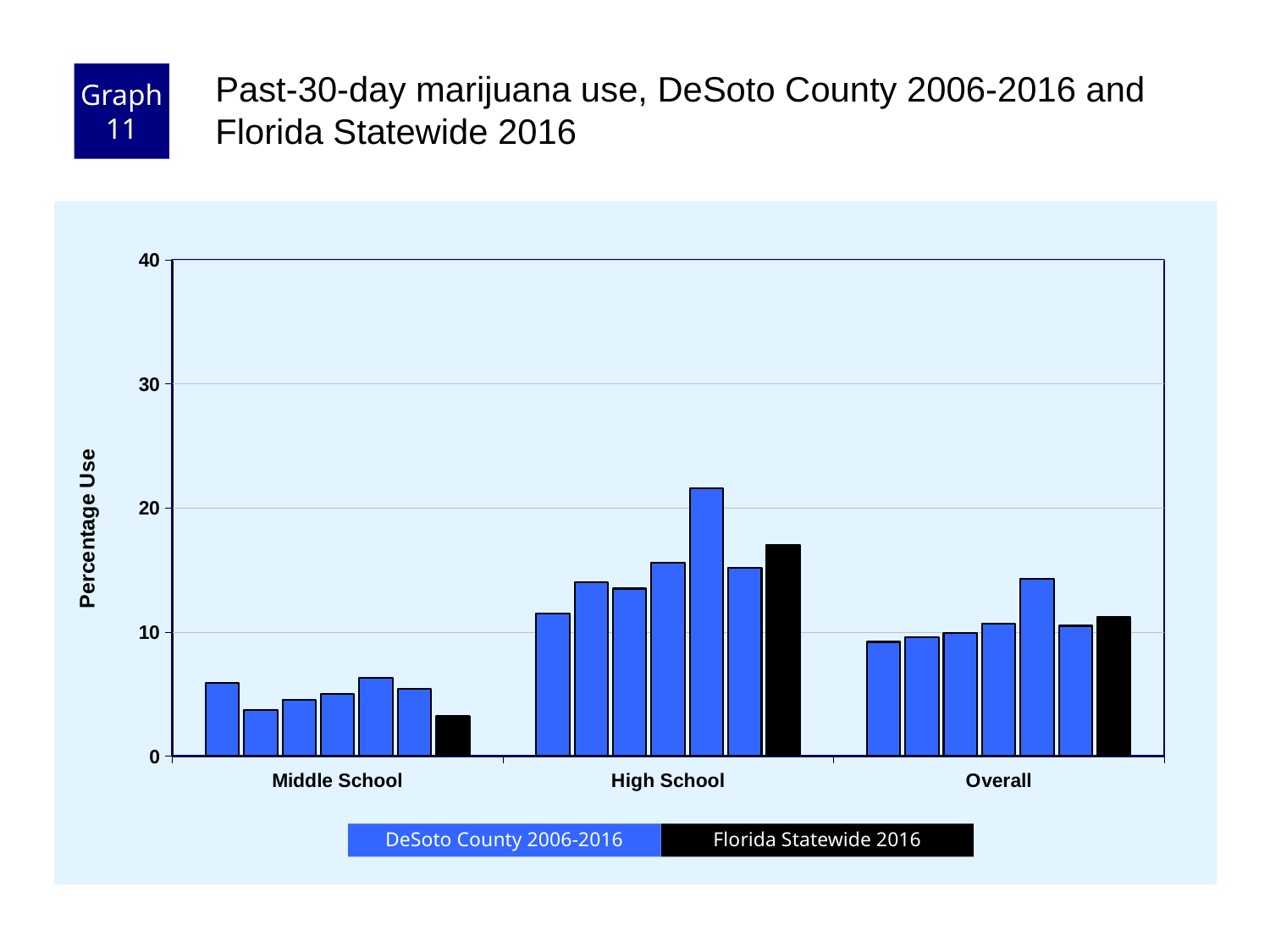
Which category has the lowest bars overall? Middle School Is the tallest DeSoto County bar in the High School group greater or less than 20? greater Which category has the highest bars overall? High School Is the Florida Statewide 2016 value for Overall greater or less than 20? less What is the label on the y axis? Percentage Use Is the Florida Statewide 2016 value for Middle School greater or less than 10? less What kind of chart is shown on the slide? bar chart How many categories are shown on the x axis? 3 Which is larger, the Florida Statewide 2016 value for High School or for Middle School? High School How many series does the legend list? 2